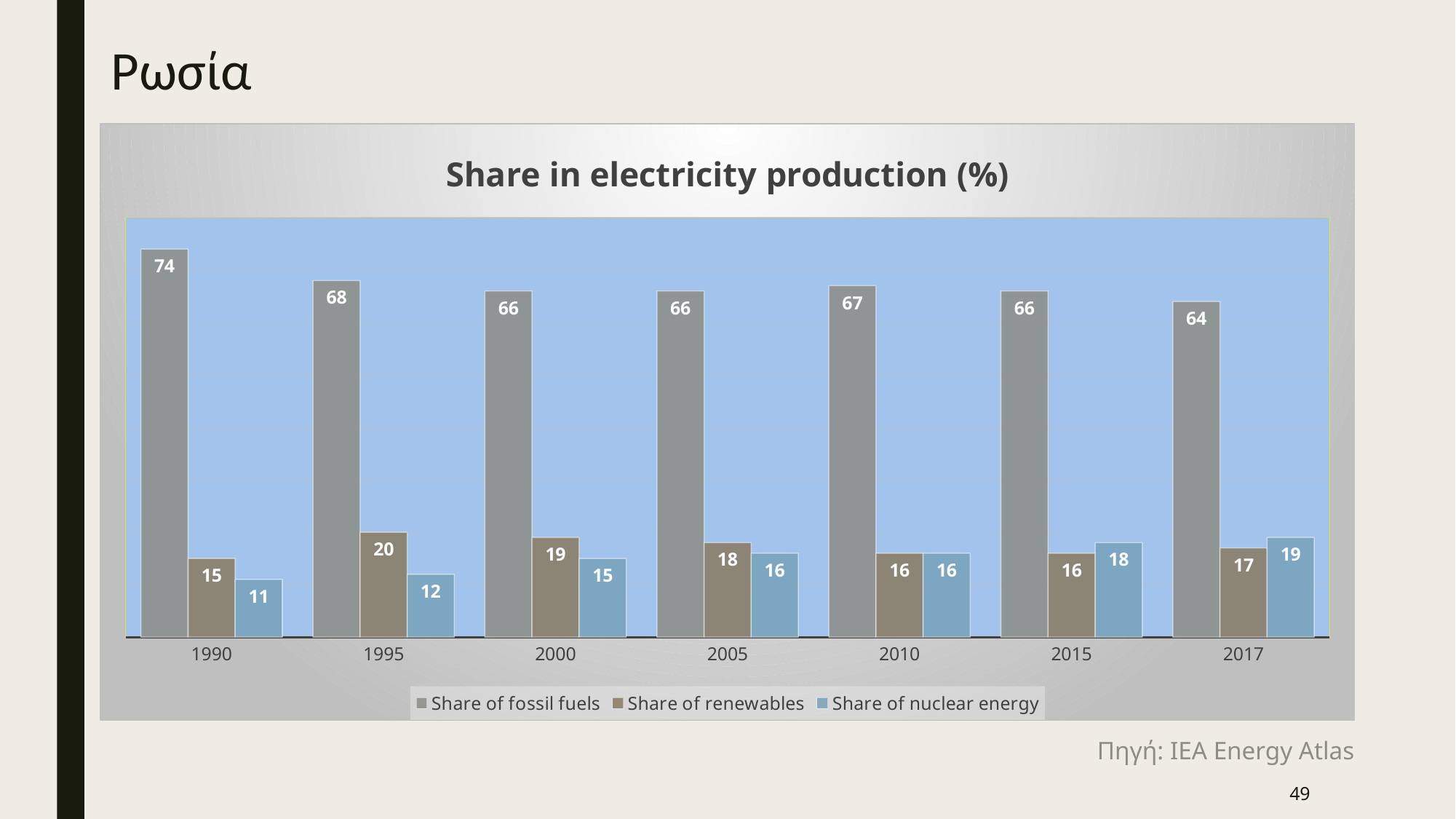
What is the share of renewables in 1995? 20 Does the share of nuclear energy generally rise or fall from 1990 to 2017? Rise What is the title of the chart? Share in electricity production (%) How many series does the legend list? 3 What kind of chart is shown on the slide? Bar chart How many years are shown on the x axis? 7 In which year is the share of fossil fuels highest? 1990 In which year is the share of nuclear energy lowest? 1990 What is the share of nuclear energy in 2017? 19 Which is larger in 2015: the share of renewables or the share of nuclear energy? Share of nuclear energy What is the share of fossil fuels in 1990? 74 What is the difference between the share of fossil fuels in 1990 and in 2017? 10